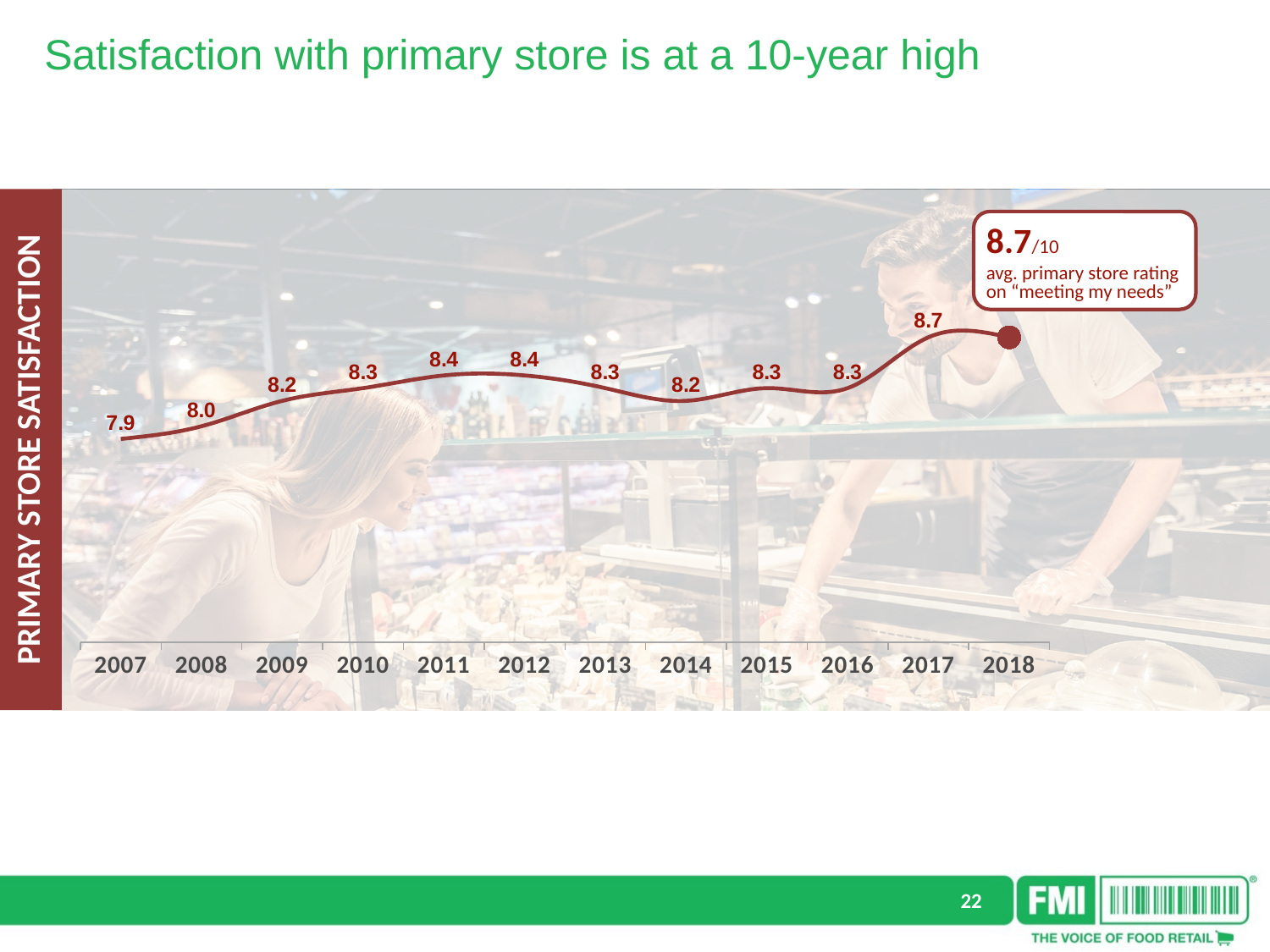
What was the primary store satisfaction rating in 2011? 8.4 What is the title of the slide? Satisfaction with primary store is at a 10-year high Which year has the lowest primary store satisfaction rating? 2007 Which year has the higher rating, 2009 or 2012? 2012 What is the difference between the 2017 rating and the 2007 rating? 0.8 Overall, does the primary store satisfaction rating rise or fall from 2007 to 2018? Rise What was the primary store satisfaction rating in 2017? 8.7 How many years are shown on the x axis of the chart? 12 What was the primary store satisfaction rating in 2014? 8.2 According to the callout, what is the average primary store rating on "meeting my needs" in 2018? 8.7/10 What was the primary store satisfaction rating in 2007? 7.9 What type of chart is used to show primary store satisfaction? Line chart